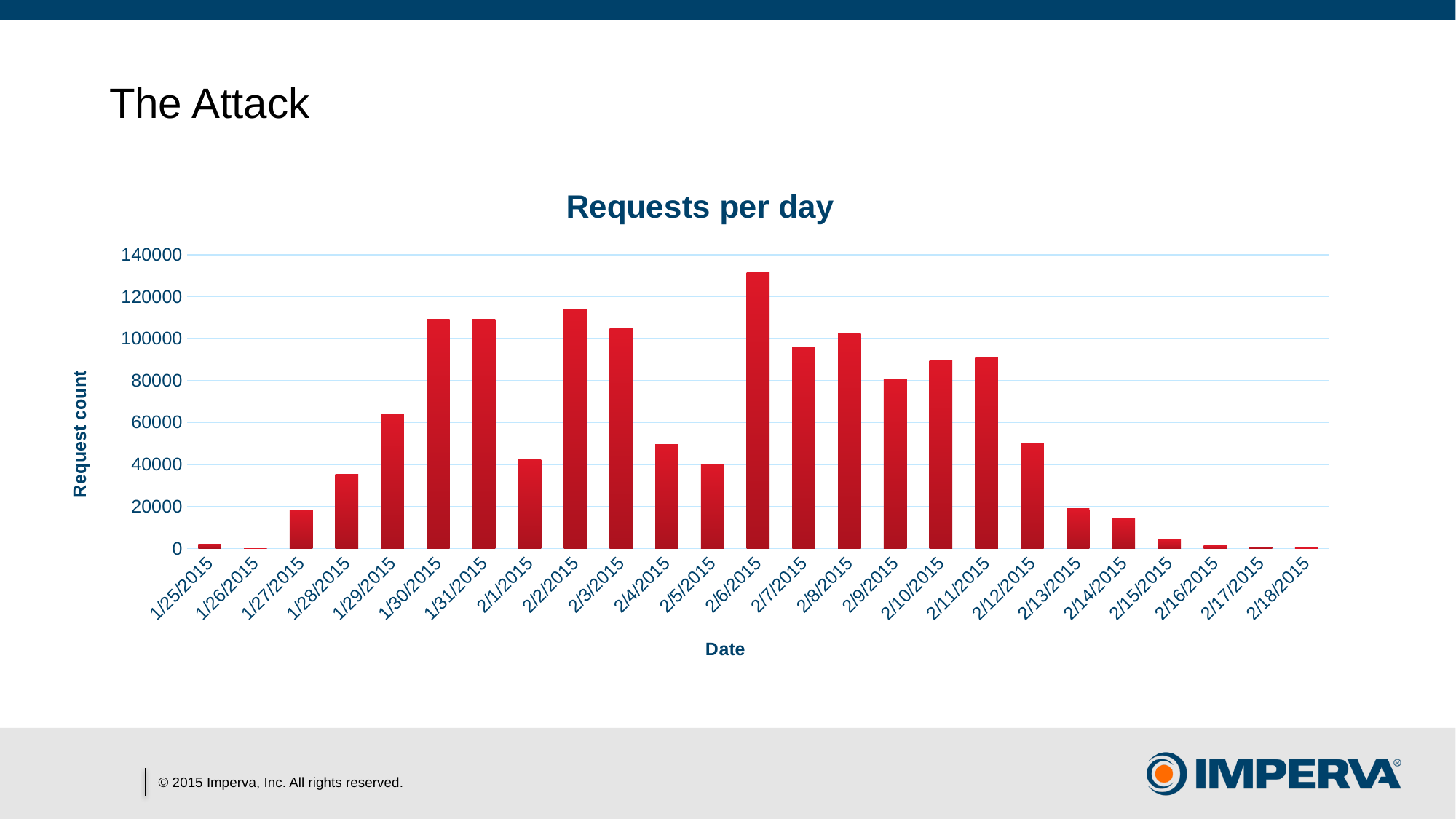
Is the value for 1/29/2015 greater or less than 60000? greater What is the label on the vertical axis of the chart? Request count Is the value for 1/28/2015 greater or less than 40000? less Which has a higher request count, 2/6/2015 or 2/7/2015? 2/6/2015 How many dates are shown on the x axis of the chart? 25 Is the value for 2/6/2015 greater or less than 120000? greater Which date has the highest request count? 2/6/2015 Do the request counts rise or fall from 2/11/2015 to 2/18/2015? fall Which has a higher request count, 1/29/2015 or 2/1/2015? 1/29/2015 What kind of chart is shown on the slide? bar chart What is the title of the chart? Requests per day